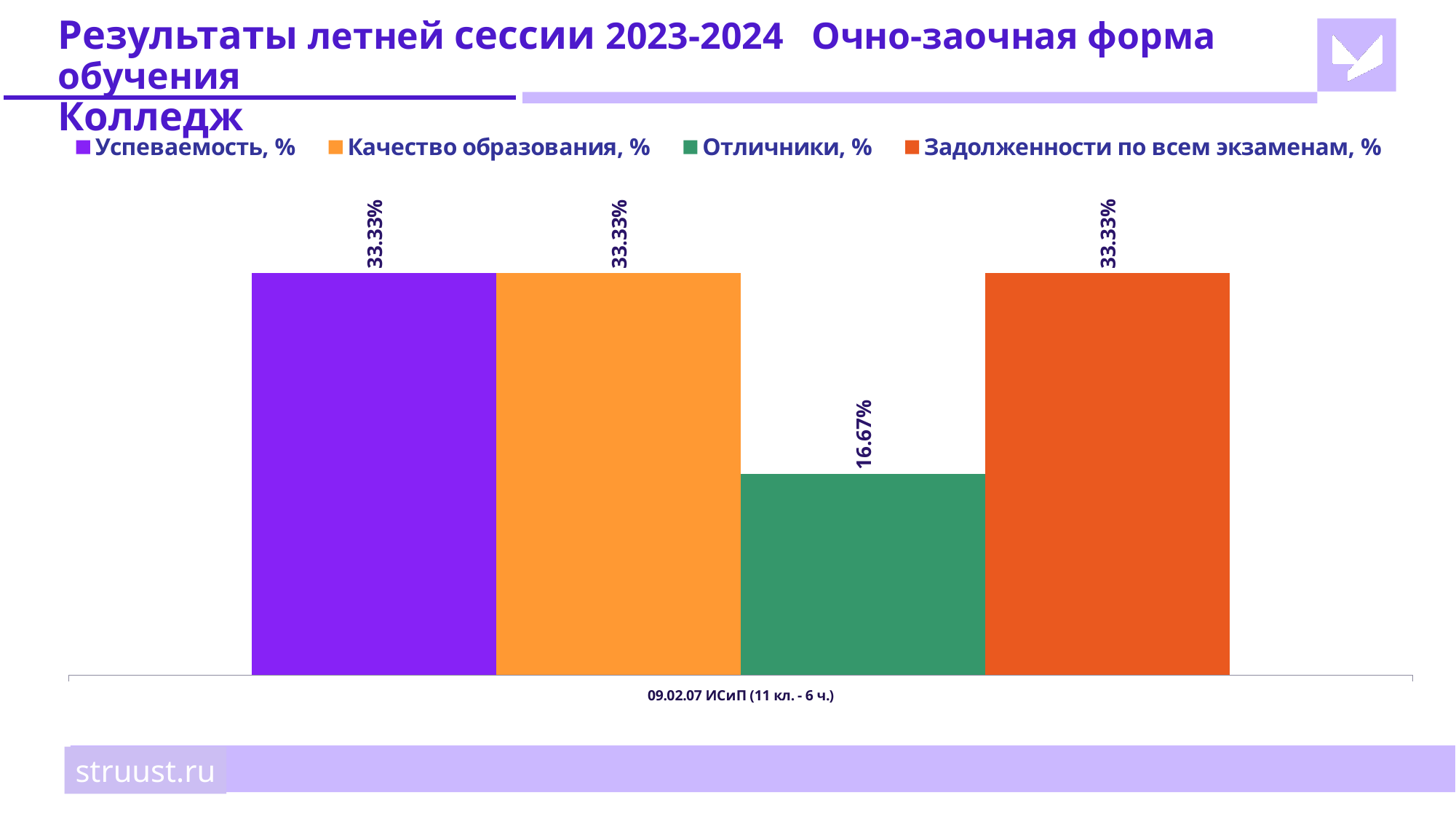
Which is larger: Качество образования, % or Отличники, %? Качество образования, % What is the value of Задолженности по всем экзаменам, % for 09.02.07 ИСиП (11 кл. - 6 ч.)? 33.33% What is the value of Качество образования, % for 09.02.07 ИСиП (11 кл. - 6 ч.)? 33.33% What is the value of Успеваемость, % for 09.02.07 ИСиП (11 кл. - 6 ч.)? 33.33% Which series is shown in green? Отличники, % What is the value of Отличники, % for 09.02.07 ИСиП (11 кл. - 6 ч.)? 16.67% Which series has the lowest value on the chart? Отличники, % What is the label of the category on the x axis? 09.02.07 ИСиП (11 кл. - 6 ч.) What is the difference between Успеваемость, % and Отличники, %? 16.66% How many series does the legend list? 4 What kind of chart is shown on the slide? Bar chart How many categories are shown on the x axis? 1